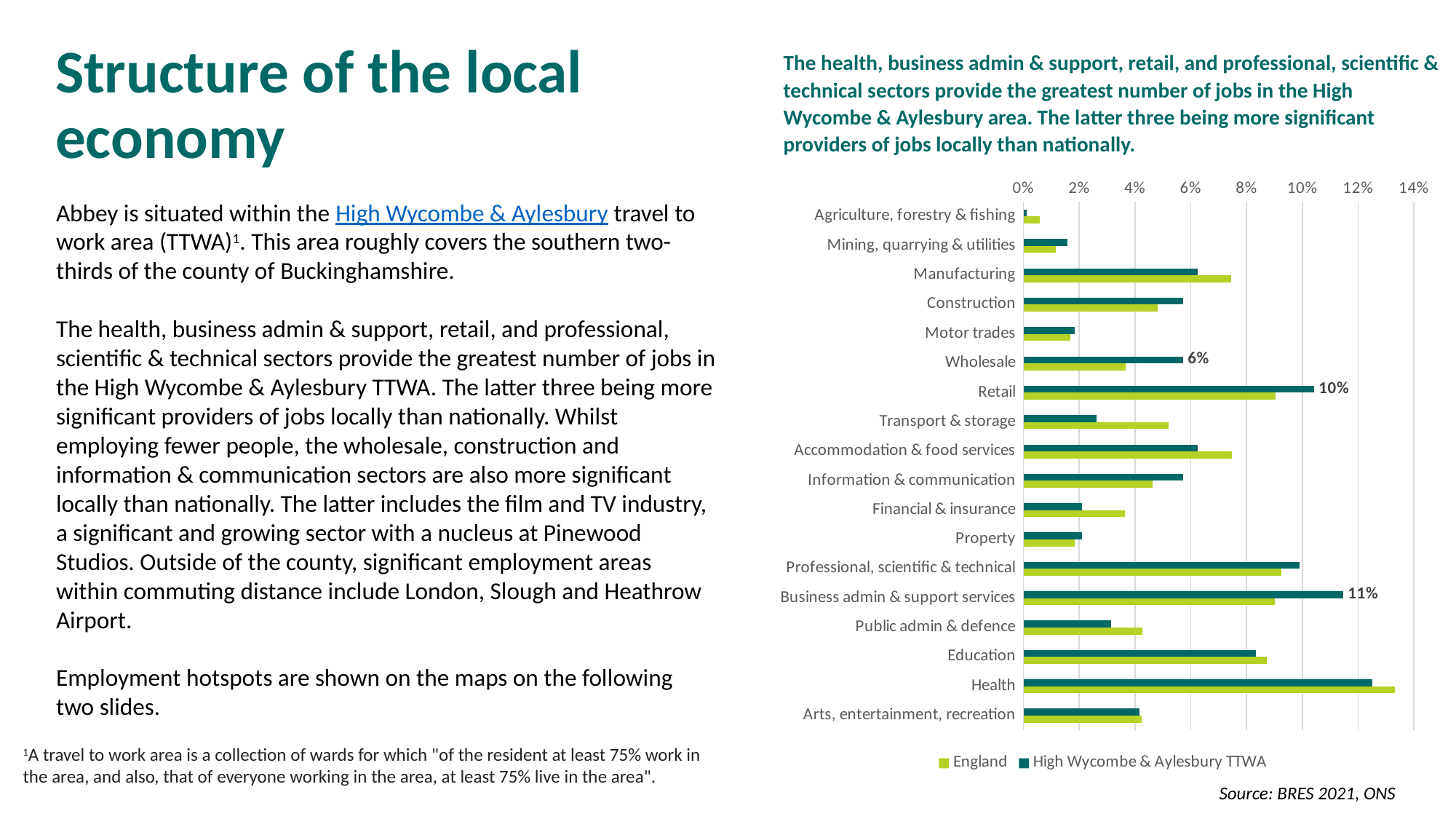
What is the value for Retail in the High Wycombe & Aylesbury TTWA series? 10% For Transport & storage, which series has the larger value: England or High Wycombe & Aylesbury TTWA? England Is the value for Health in the England series greater or less than 12%? greater What is the difference between the High Wycombe & Aylesbury TTWA values for Business admin & support services and Retail? 1% Which colour represents the England series in the chart legend? Light green How many series does the chart legend list? 2 How many sector categories are plotted on the chart? 18 Which sector has the lowest value in the England series? Agriculture, forestry & fishing What is the value for Business admin & support services in the High Wycombe & Aylesbury TTWA series? 11% What kind of chart is shown on the slide? Bar chart Which sector has the highest value in the High Wycombe & Aylesbury TTWA series? Health What is the value for Wholesale in the High Wycombe & Aylesbury TTWA series? 6%